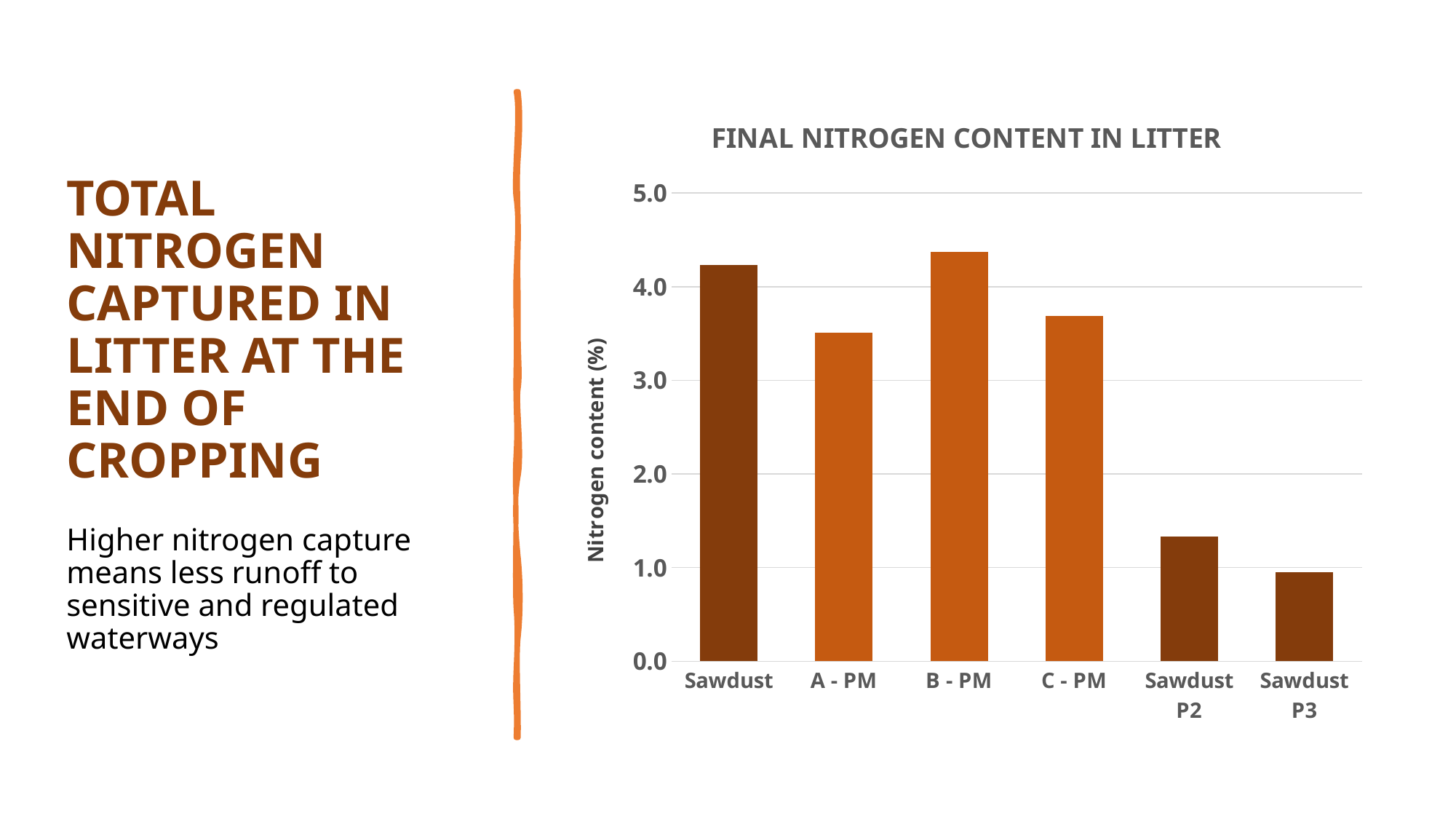
What kind of chart is shown on the slide? bar chart What is the title of the chart? FINAL NITROGEN CONTENT IN LITTER Is the value for C - PM greater or less than 4.0? less Which category has the highest nitrogen content? B - PM Which has a higher nitrogen content, A - PM or C - PM? C - PM What is the label on the y axis of the chart? Nitrogen content (%) Which category has the lowest nitrogen content? Sawdust P3 Is the value for A - PM greater or less than 3.0? greater Is the value for Sawdust P2 greater or less than 1.0? greater How many categories are shown on the x axis of the chart? 6